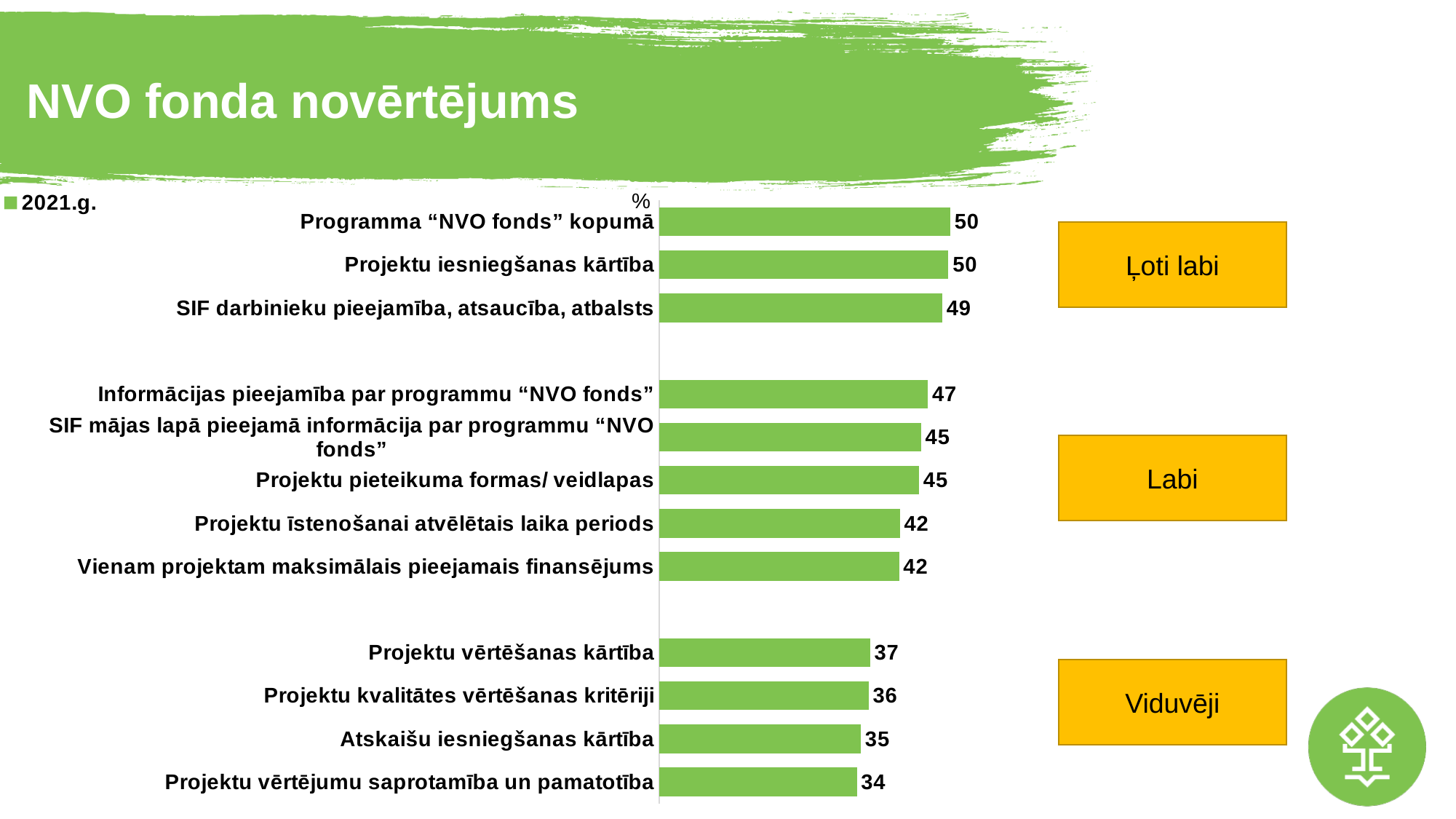
What is the value for "SIF darbinieku pieejamība, atsaucība, atbalsts"? 49 What is the value for "Projektu īstenošanai atvēlētais laika periods"? 42 How many series does the legend list? 1 What is the value for "Projektu iesniegšanas kārtība"? 50 What is the difference between the values for "Programma “NVO fonds” kopumā" and "Projektu vērtēšanas kārtība"? 13 What is the difference between the values for "Informācijas pieejamība par programmu “NVO fonds”" and "Projektu kvalitātes vērtēšanas kritēriji"? 11 Which category has the lowest value? Projektu vērtējumu saprotamība un pamatotība What is the value for "Atskaišu iesniegšanas kārtība"? 35 What kind of chart is shown on the slide? Bar chart Which is larger: the value for "Projektu pieteikuma formas/ veidlapas" or the value for "Projektu vērtēšanas kārtība"? Projektu pieteikuma formas/ veidlapas What series name is shown in the chart legend? 2021.g. How many categories are shown in the chart? 12